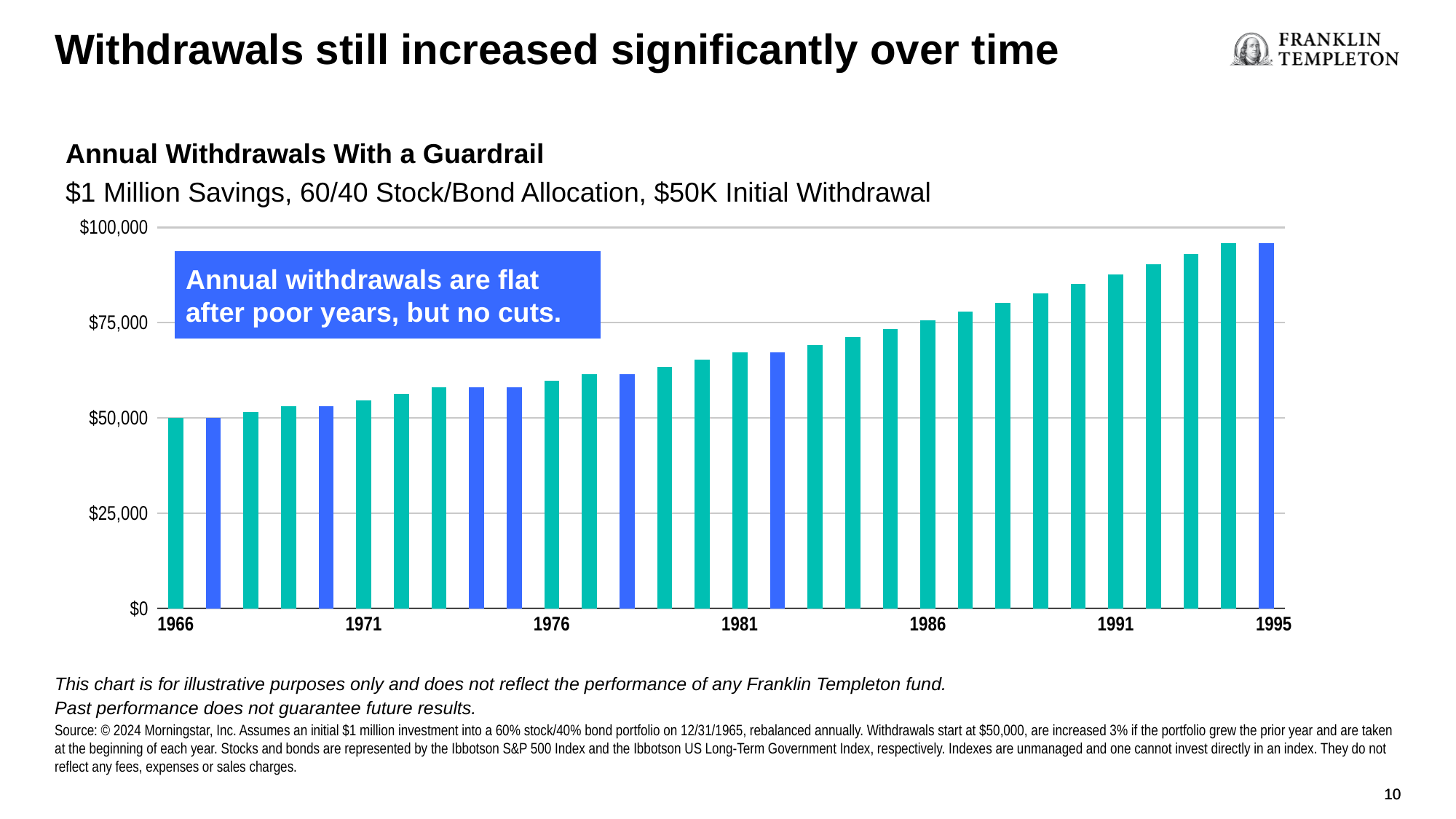
Is the value for 1991 greater or less than $75,000? greater How many years (bars) are plotted on the chart? 30 Do the annual withdrawals generally rise or fall from 1966 to 1995? rise Is the value for 1976 greater or less than $50,000? greater Is the value for 1971 greater or less than $75,000? less Which year has the larger withdrawal, 1966 or 1995? 1995 What is the title of the chart? Annual Withdrawals With a Guardrail What is the annual withdrawal value for 1966? $50,000 What kind of chart is shown on the slide? bar chart What does the callout box on the chart say? Annual withdrawals are flat after poor years, but no cuts.